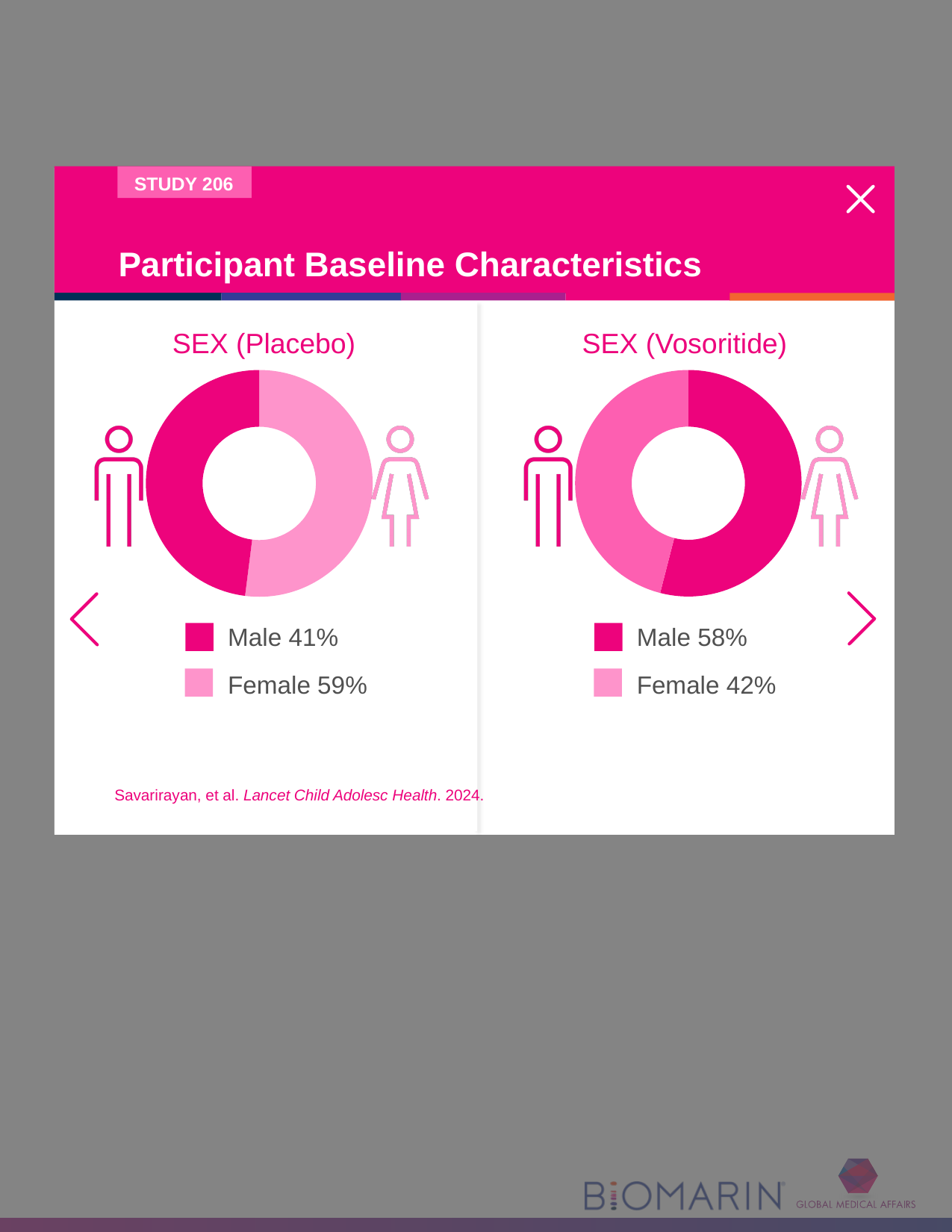
How many charts are shown on the slide? 2 In the SEX (Placebo) chart, what is the difference between the female and male percentages? 18% In the SEX (Placebo) chart, what percentage of participants are female? 59% What kind of chart is the SEX (Placebo) chart? Pie chart (donut) How many categories does the SEX (Vosoritide) chart show? 2 In the SEX (Vosoritide) chart, which category has the smaller share? Female Is the male share larger in the SEX (Placebo) chart or the SEX (Vosoritide) chart? SEX (Vosoritide) In the SEX (Placebo) chart, which category has the larger share? Female In the SEX (Vosoritide) chart, what is the difference between the male and female percentages? 16% In the SEX (Placebo) chart, what percentage of participants are male? 41% In the SEX (Vosoritide) chart, what percentage of participants are female? 42% In the SEX (Vosoritide) chart, what percentage of participants are male? 58%